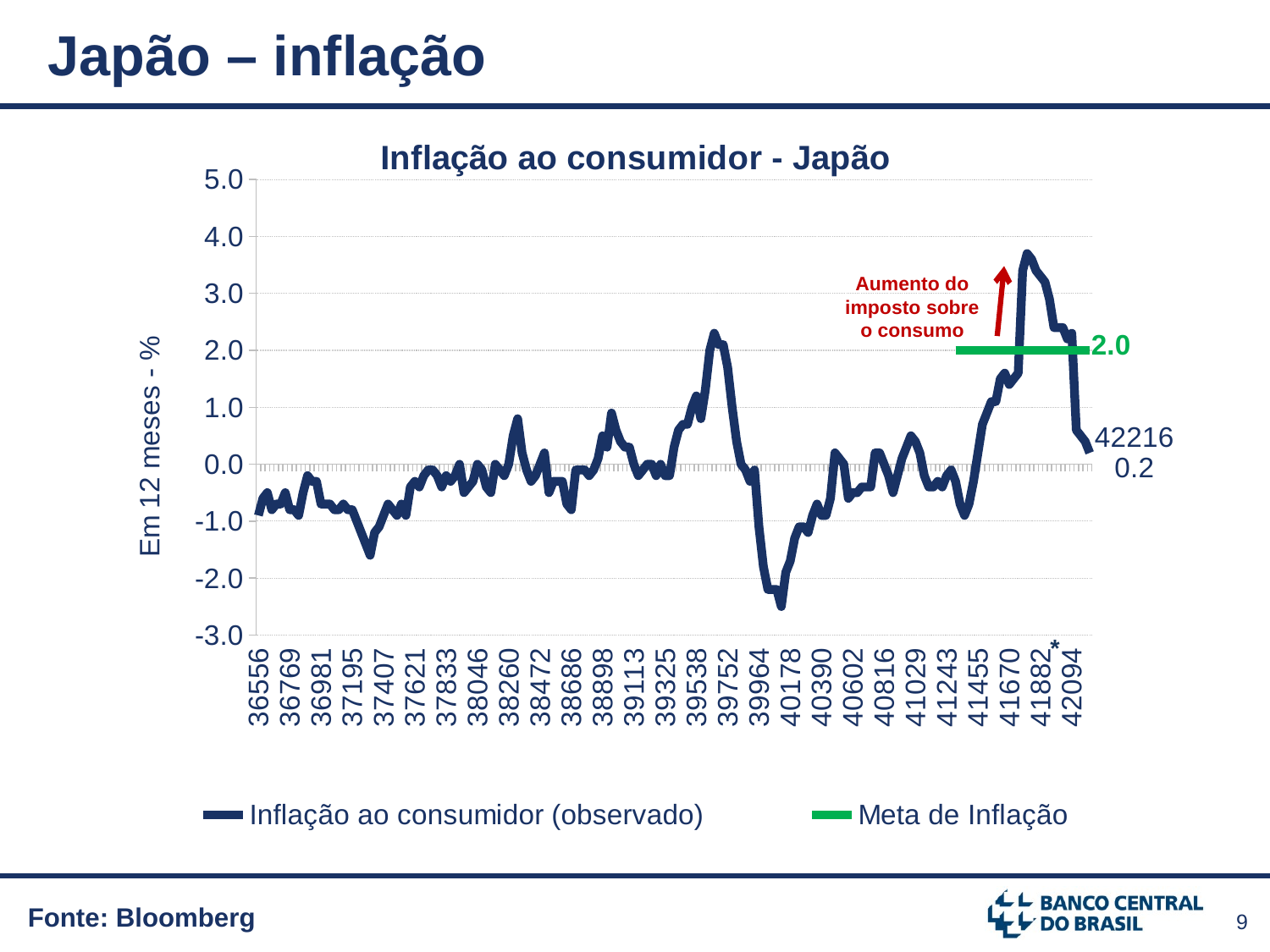
Is the observed inflation value at the first point (36556) greater or less than 0.0? less Which is larger at the end of the series: the observed inflation (0.2) or the Meta de Inflação (2.0)? Meta de Inflação What is the label on the vertical axis of the chart? Em 12 meses - % What kind of chart is shown on the slide? line chart What is the difference between the Meta de Inflação (2.0) and the last observed inflation value (0.2)? 1.8 What is the observed consumer inflation value at the last labelled point (42216)? 0.2 Is the peak of the observed inflation line near 41670–41882 greater or less than 3.0? greater What is the value of the Meta de Inflação line? 2.0 What is the title of the chart? Inflação ao consumidor - Japão Is the lowest point of the observed inflation line near 40178 greater or less than -2.0? less How many series does the legend list? 2 Between 41243 and 41670, does the observed inflation line rise or fall? rise